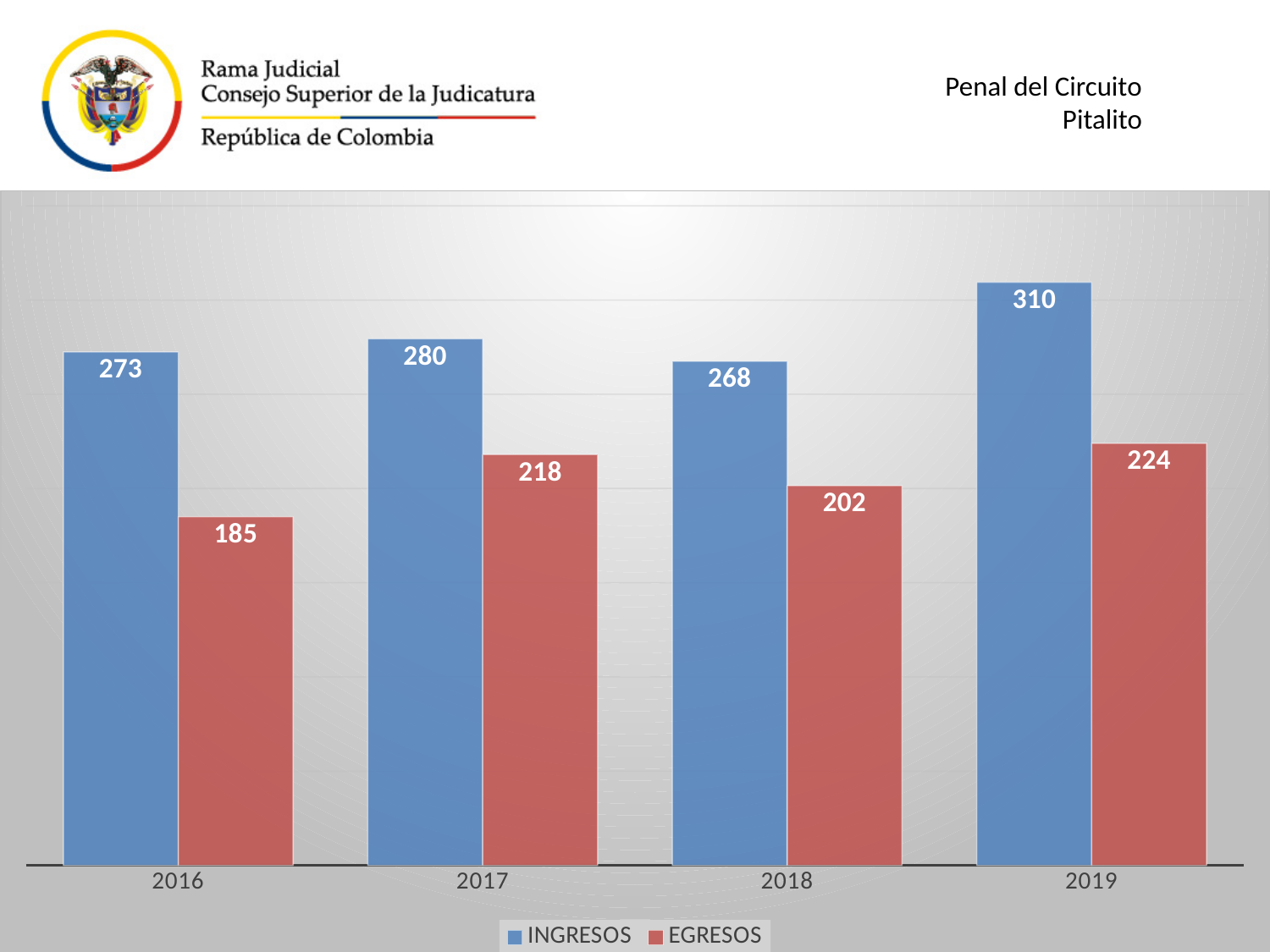
Which colour represents the EGRESOS series? Red Which year has the highest INGRESOS value? 2019 What is the INGRESOS value for 2016? 273 What is the difference between the INGRESOS values for 2019 and 2018? 42 Which is larger, EGRESOS in 2017 or EGRESOS in 2018? EGRESOS in 2017 How many years are shown on the x axis? 4 How many series does the legend list? 2 What is the difference between INGRESOS and EGRESOS in 2017? 62 Which year has the lowest EGRESOS value? 2016 What is the EGRESOS value for 2019? 224 What is the EGRESOS value for 2018? 202 What kind of chart is shown on the slide? Bar chart